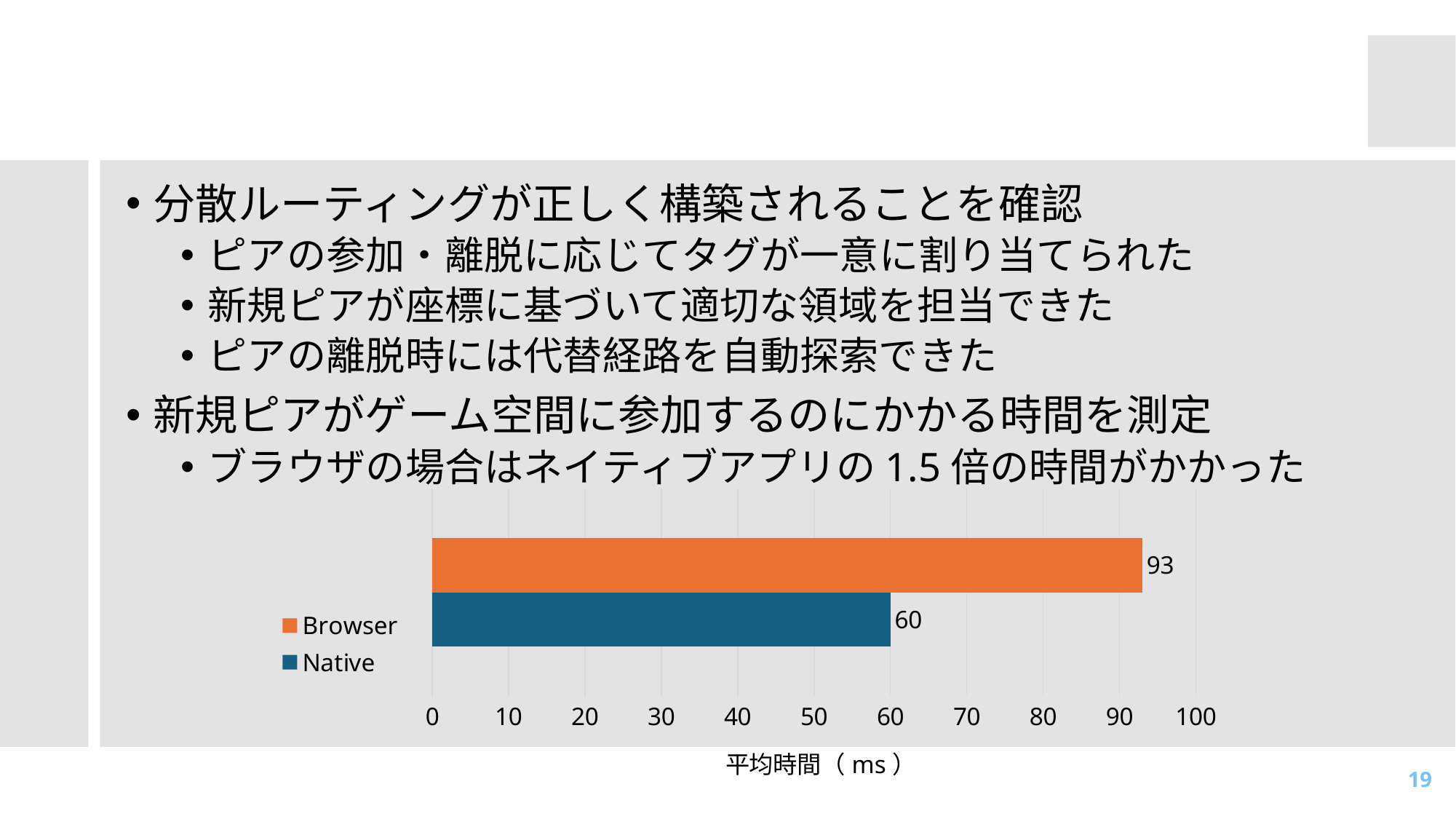
Is the value for Native greater or less than 70? less Is the value for Browser greater or less than 80? greater How many series does the legend list? 2 What is the difference between the Browser and Native values? 33 Which series has the lowest value? Native What is the value for Browser? 93 What kind of chart is shown on the slide? bar chart What colour is the Browser bar? orange Which is larger, the value for Browser or the value for Native? Browser What is the label of the horizontal axis? 平均時間 ( ms ) What is the value for Native? 60 Which series has the highest value? Browser